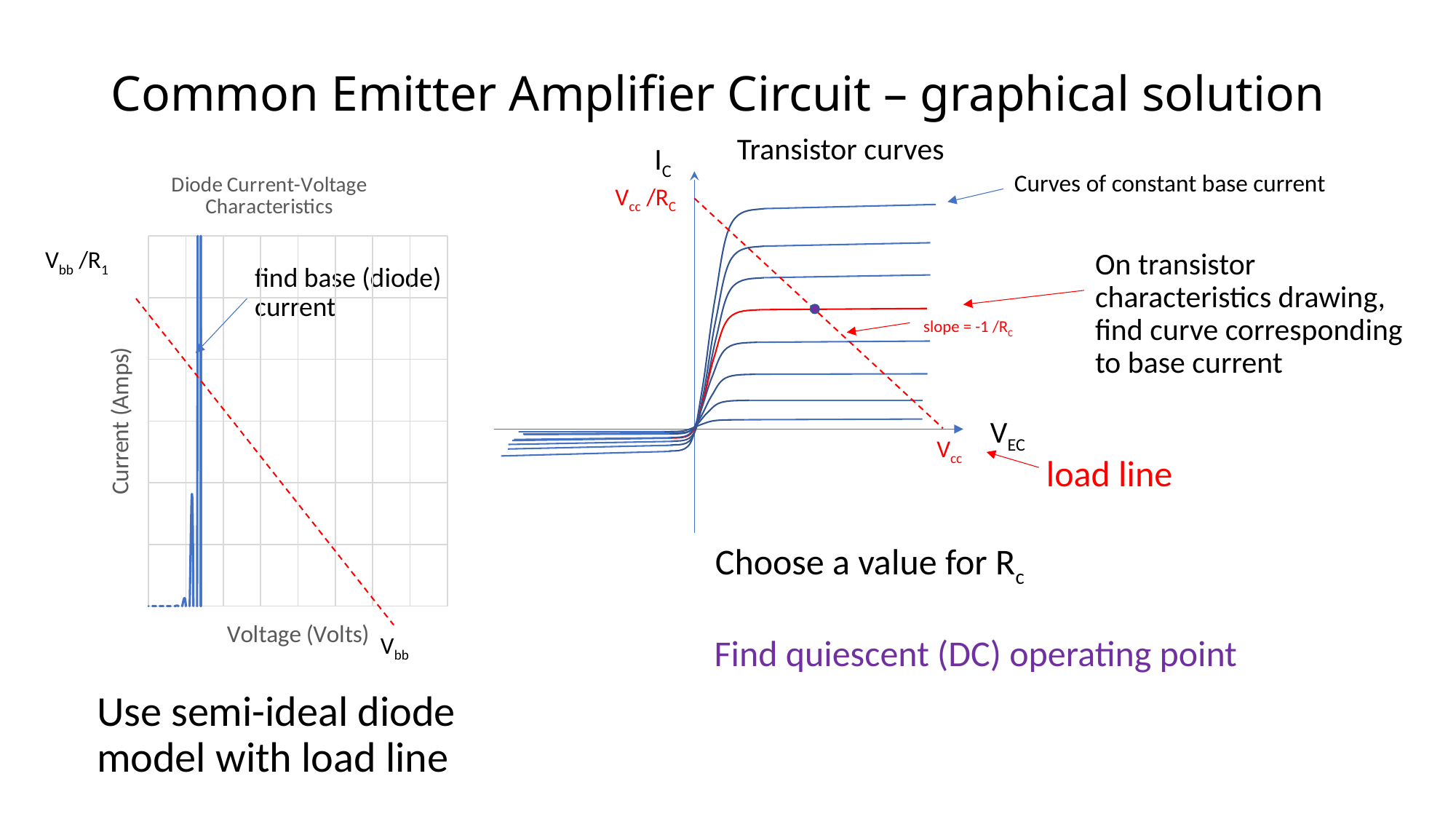
On the Transistor curves chart, what is the slope of the load line as labelled on the chart? -1 /Rc What kind of chart is the Diode Current-Voltage Characteristics chart on the left? line chart On the Transistor curves chart, does the dashed load line rise or fall as VEC increases? fall On the Diode Current-Voltage Characteristics chart, what label marks where the load line meets the current axis? Vbb /R1 On the Transistor curves chart, what label marks the load line's intercept on the horizontal VEC axis? Vcc On the Transistor curves chart, what label marks the load line's intercept on the vertical IC axis? Vcc /RC On the Diode Current-Voltage Characteristics chart, what is the y-axis title? Current (Amps) On the Diode Current-Voltage Characteristics chart, does the red dashed load line rise or fall as voltage increases? fall On the Diode Current-Voltage Characteristics chart, what label marks where the load line meets the voltage axis? Vbb On the Diode Current-Voltage Characteristics chart, what is the x-axis title? Voltage (Volts)